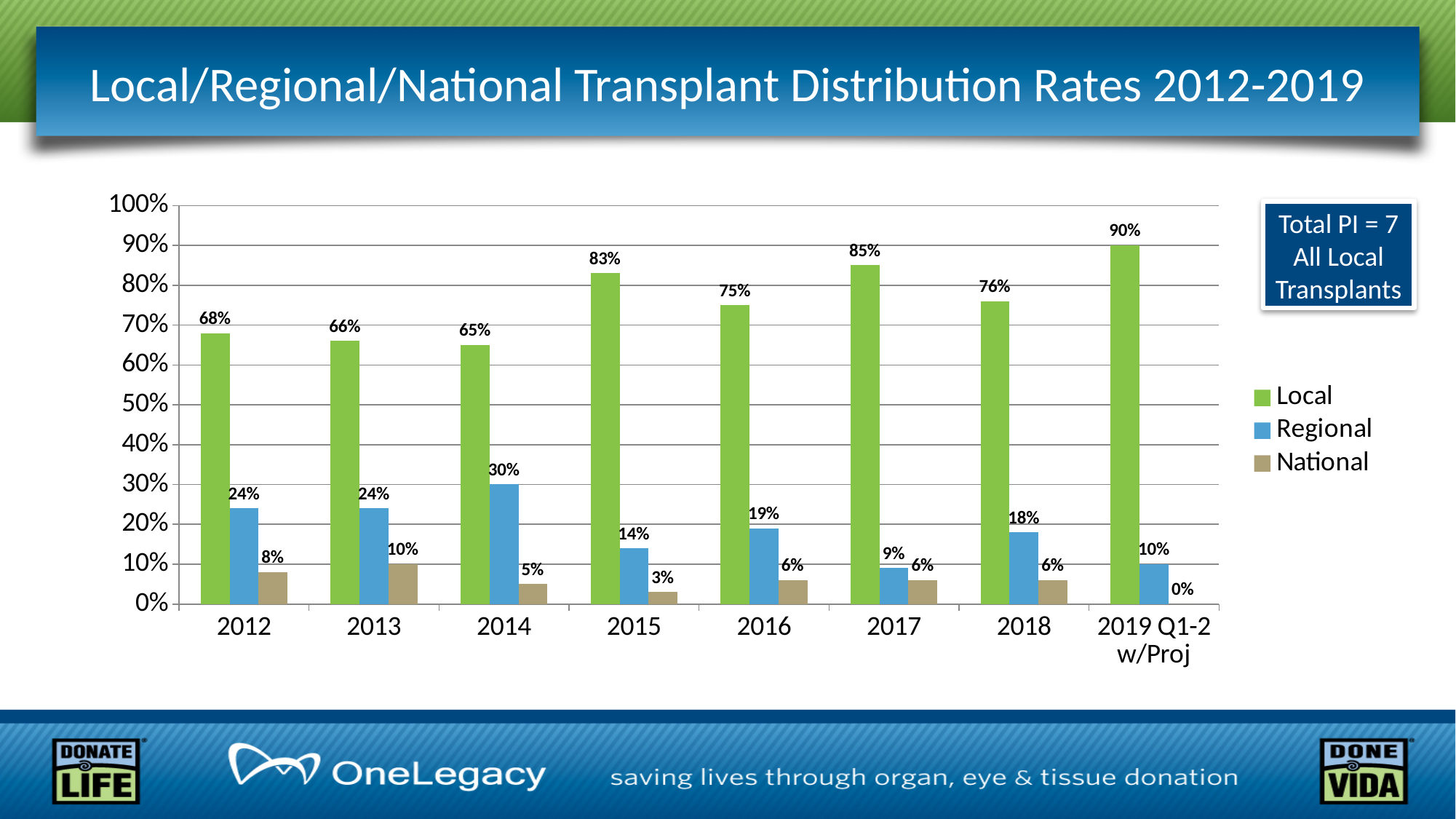
Which is larger, the Regional value for 2016 or the Regional value for 2018? 2016 What is the Local value for 2015? 83% How many years (categories) are shown on the x axis? 8 How many series does the legend list? 3 What kind of chart is shown on the slide? bar chart Which year has the highest Local value? 2019 Q1-2 w/Proj What does the text box at the top right of the chart say? Total PI = 7 All Local Transplants What is the National value for 2013? 10% What is the difference between the Local values for 2017 and 2018? 9% Does the Local value rise or fall from 2018 to 2019 Q1-2 w/Proj? rise What is the Regional value for 2014? 30%